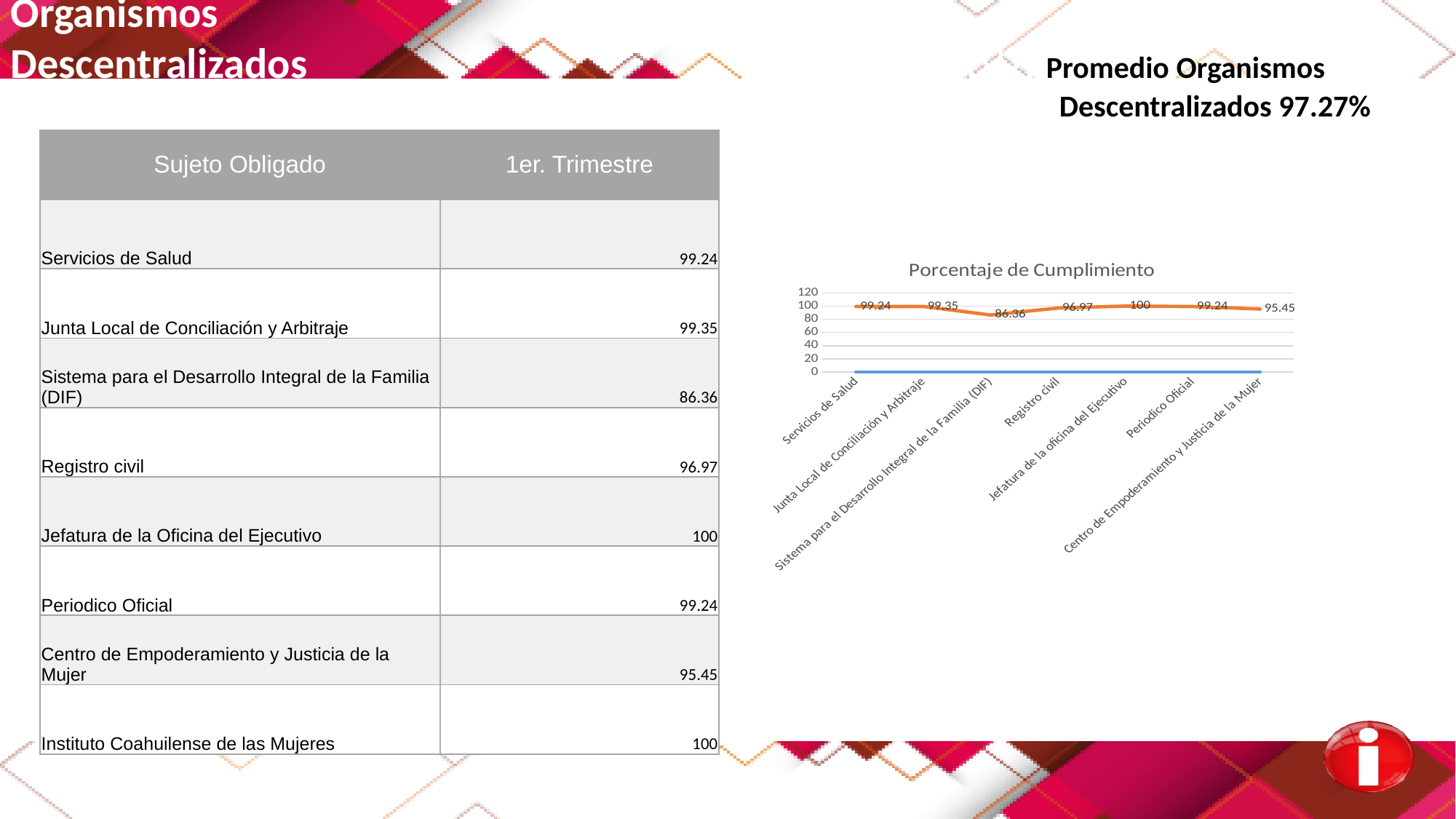
In the "Porcentaje de Cumplimiento" chart, which is larger: the value for Registro civil or the value for Centro de Empoderamiento y Justicia de la Mujer? Registro civil In the "Porcentaje de Cumplimiento" chart, what is the value for Centro de Empoderamiento y Justicia de la Mujer? 95.45 How many categories are shown on the x axis of the "Porcentaje de Cumplimiento" chart? 7 In the "Porcentaje de Cumplimiento" chart, what is the difference between the values for Jefatura de la oficina del Ejecutivo and Sistema para el Desarrollo Integral de la Familia (DIF)? 13.64 In the "Porcentaje de Cumplimiento" chart, which category has the lowest value? Sistema para el Desarrollo Integral de la Familia (DIF) In the "Porcentaje de Cumplimiento" chart, what is the value for Junta Local de Conciliación y Arbitraje? 99.35 What is the title of the chart on the slide? Porcentaje de Cumplimiento In the "Porcentaje de Cumplimiento" chart, what is the value for Sistema para el Desarrollo Integral de la Familia (DIF)? 86.36 In the "Porcentaje de Cumplimiento" chart, is the value for Sistema para el Desarrollo Integral de la Familia (DIF) greater or less than 80? greater What type of chart is "Porcentaje de Cumplimiento"? line chart In the "Porcentaje de Cumplimiento" chart, what is the value for Registro civil? 96.97 In the "Porcentaje de Cumplimiento" chart, which category has the highest value? Jefatura de la oficina del Ejecutivo